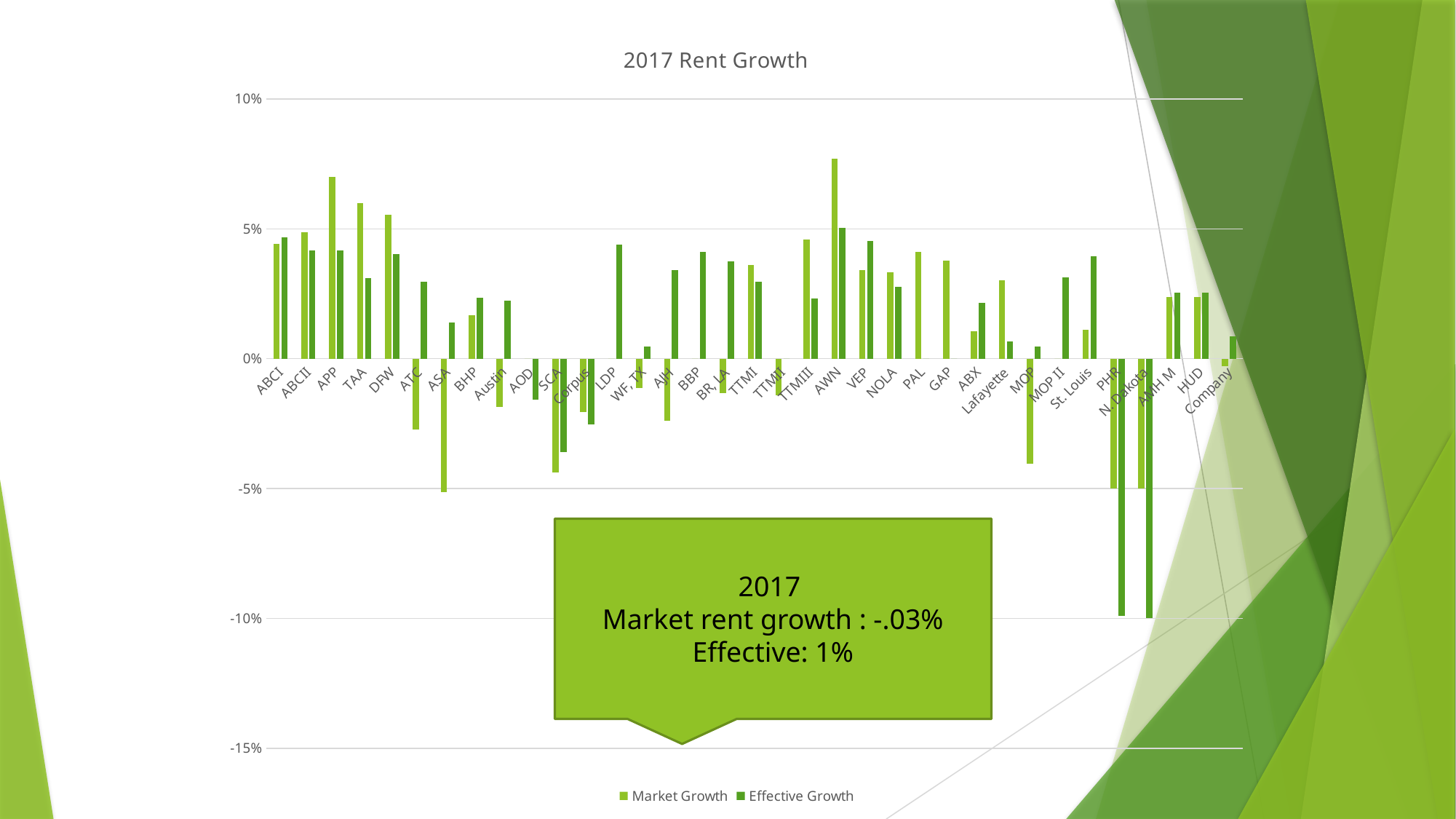
For AWN, which is larger, the Market Growth value or the Effective Growth value? Market Growth Is the Market Growth value for AWN greater or less than 5%? greater What are the two series named in the legend? Market Growth and Effective Growth How many series does the legend list? 2 How many categories are shown on the x axis? 35 Which category has the highest Market Growth value? AWN What type of chart is shown on the slide? bar chart Is the Market Growth value for MOP greater or less than 0%? less Is the Market Growth value for APP greater or less than 5%? greater What is the title of the chart? 2017 Rent Growth Which is larger, the Market Growth value for APP or the Market Growth value for TAA? APP